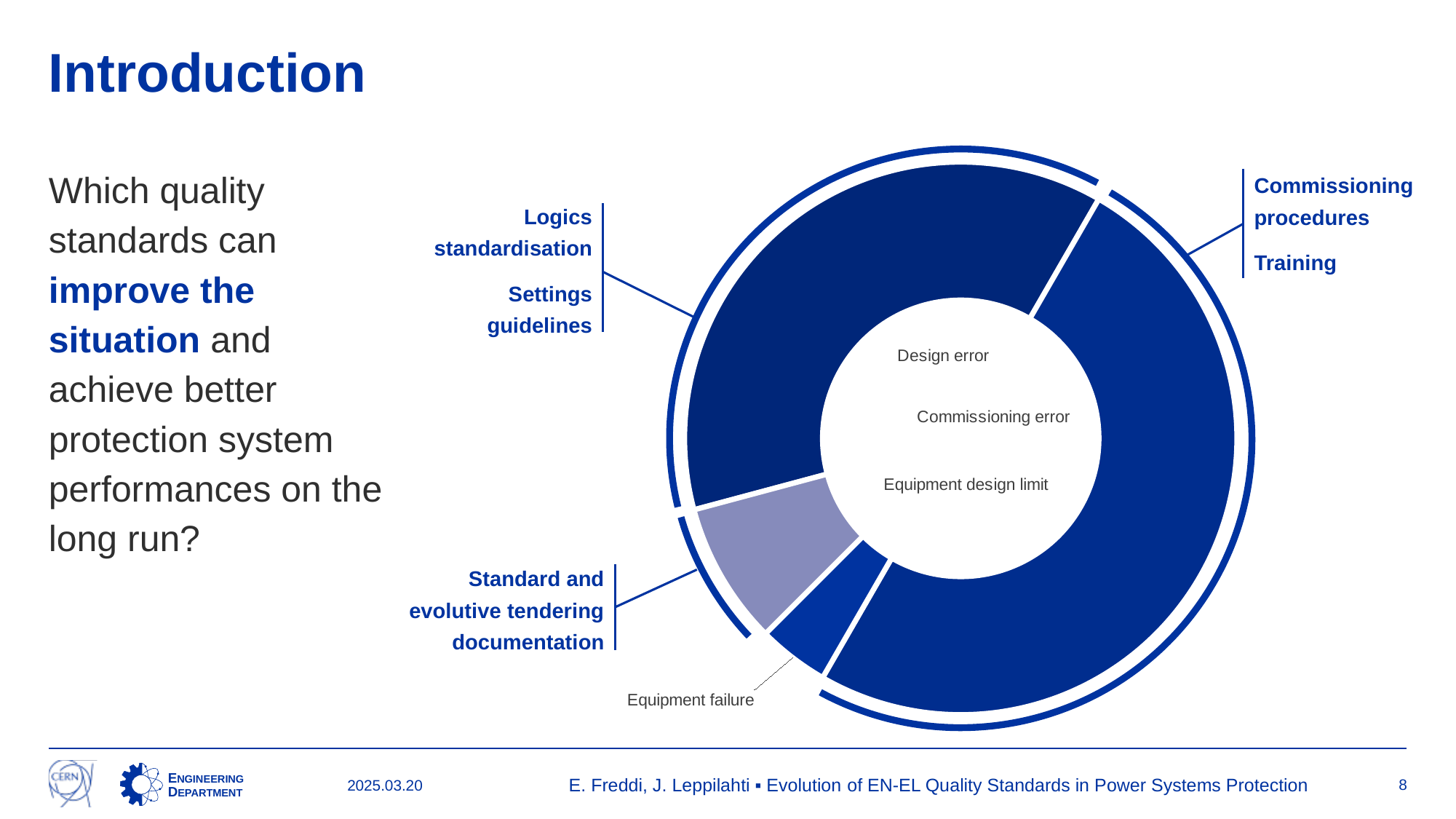
Which quality standards are annotated next to the Commissioning error slice? Commissioning procedures; Training Which slice is larger, Commissioning error or Equipment failure? Commissioning error Which slice is larger, Commissioning error or Design error? Commissioning error Which category has the largest slice in the donut chart? Commissioning error How many categories does the donut chart show? 4 Which category is labelled outside the donut chart with a leader line? Equipment failure Which slice is larger, Design error or Equipment design limit? Design error What kind of chart is shown on the slide? Pie chart (donut) Which slice of the donut chart is drawn in a light grey-purple colour rather than blue? Equipment design limit